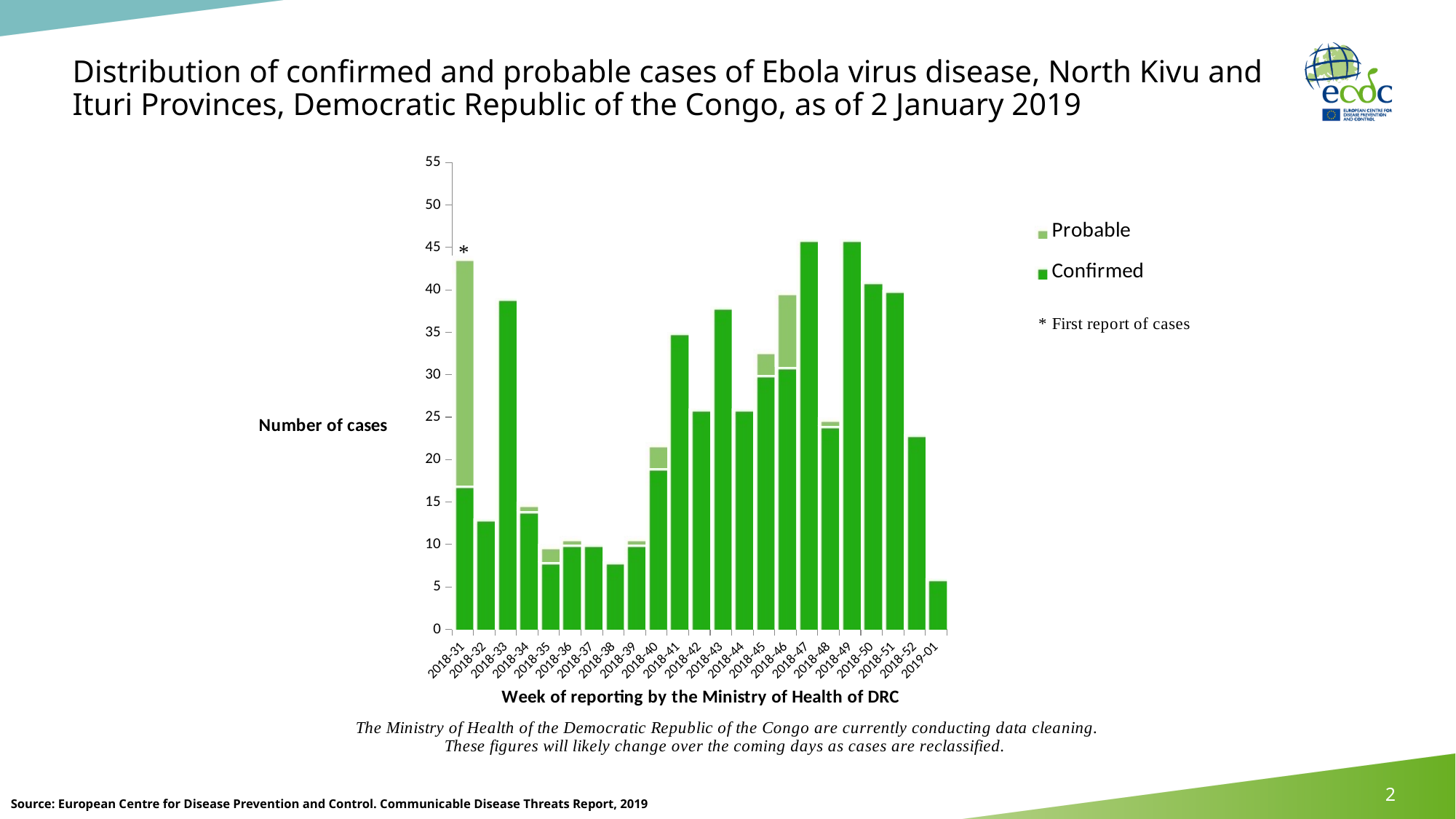
Which reporting week has the lowest total number of cases? 2019-01 Do the number of cases rise or fall from week 2018-49 to week 2019-01? fall Which week has more cases, 2018-43 or 2018-44? 2018-43 How many series does the legend list? 2 What does the asterisk above the first bar indicate? First report of cases Is the number of cases for week 2018-52 greater or less than 20? greater Is the total number of cases for week 2018-31 greater or less than 40? greater What kind of chart is shown on the slide? Stacked bar chart Is the number of confirmed cases for week 2018-33 greater or less than 35? greater Which week has more cases, 2018-32 or 2018-33? 2018-33 How many reporting weeks are shown on the x axis? 23